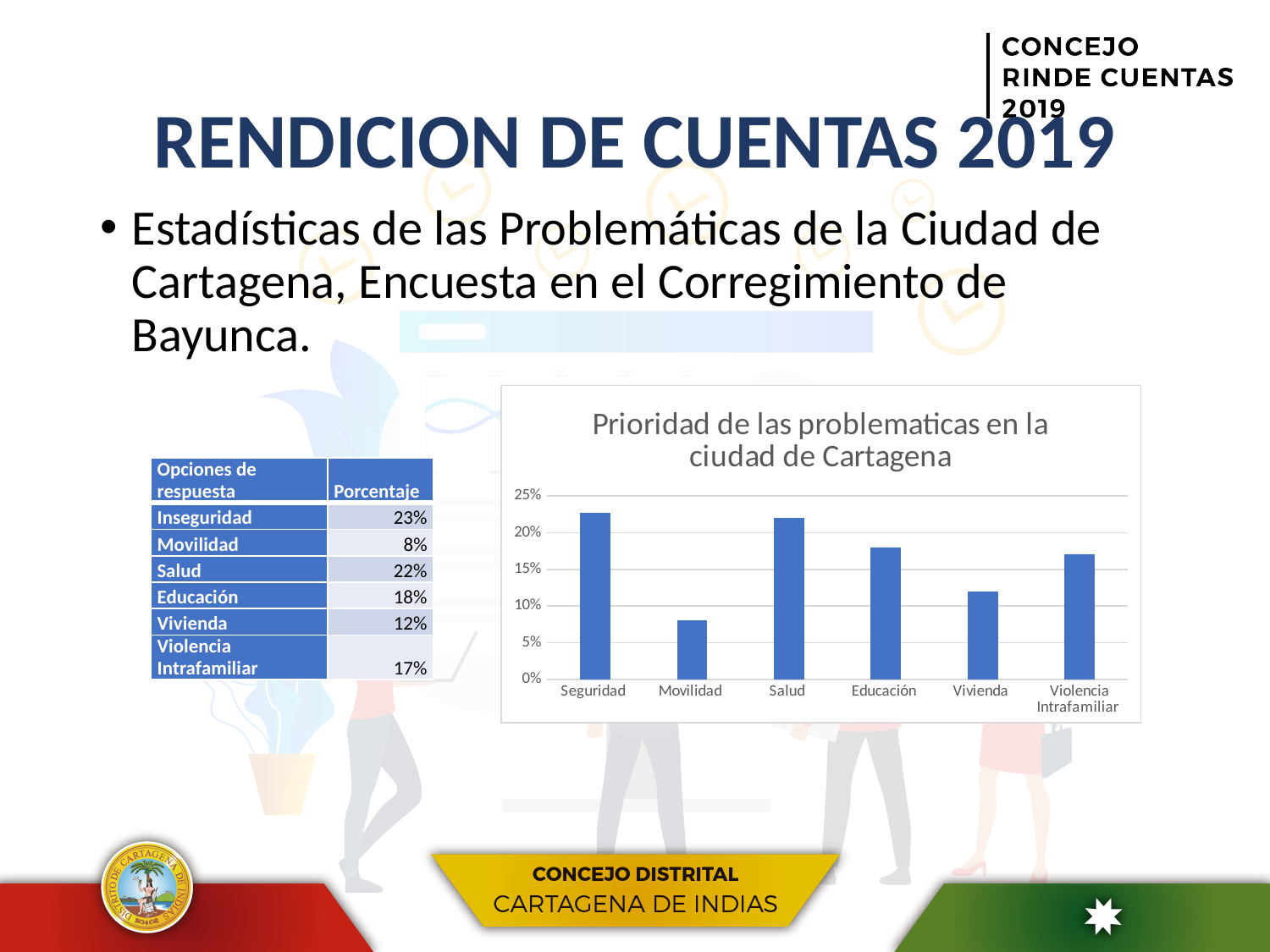
Which category has the lowest value in the chart? Movilidad What is the percentage for Violencia Intrafamiliar? 17% What is the percentage for Vivienda? 12% Is the value for Salud greater or less than 20%? greater What is the percentage for Movilidad? 8% What is the percentage for Educación? 18% What is the difference between the values for Educación and Vivienda? 6% Is the value for Movilidad greater or less than 10%? less Which is larger, the value for Educación or the value for Vivienda? Educación What is the title of the chart? Prioridad de las problematicas en la ciudad de Cartagena How many categories are plotted on the chart? 6 What kind of chart is shown on the slide? bar chart